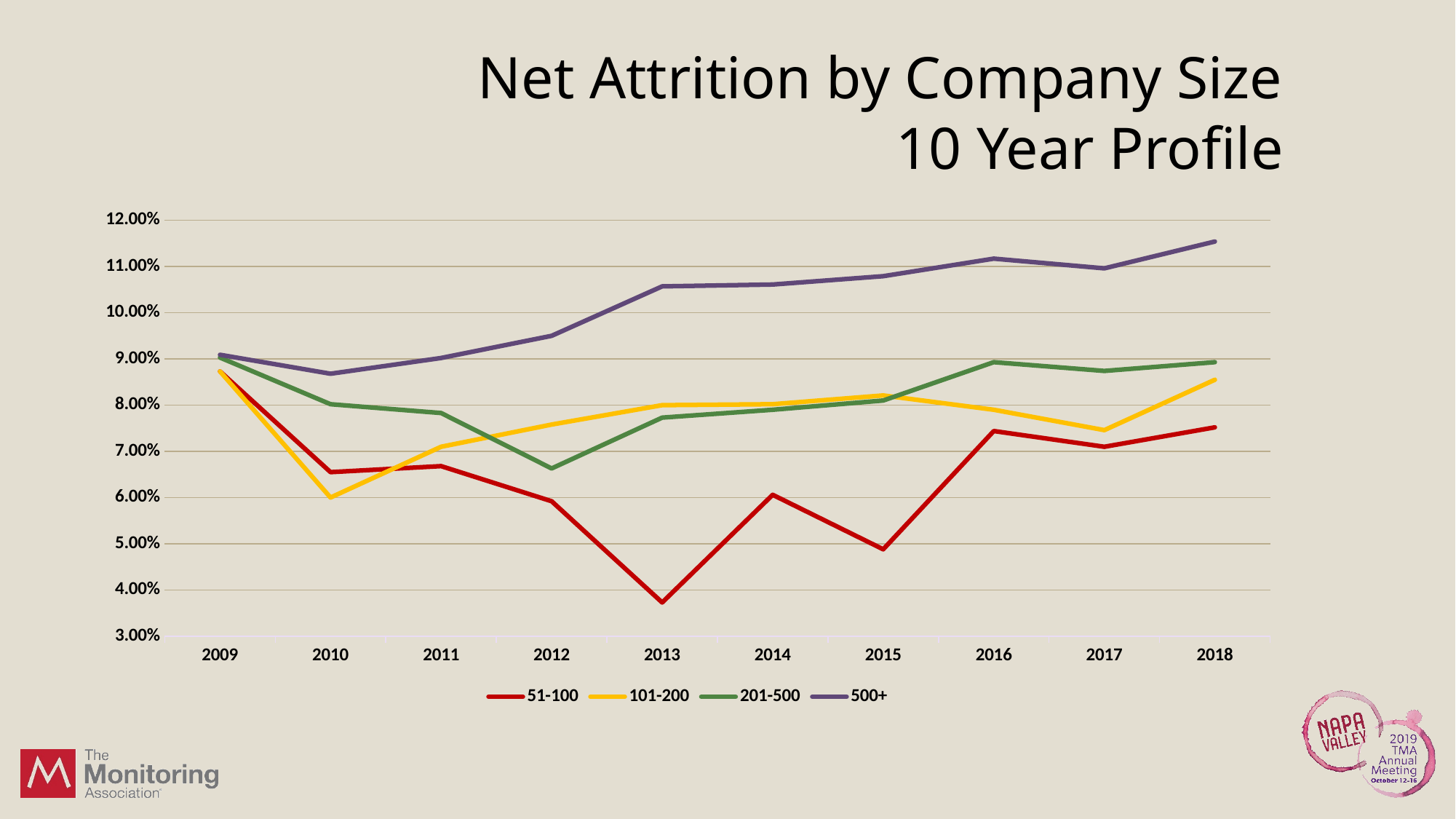
What colour is the line for the 51-100 series? Red What kind of chart is shown on the slide? Line chart Is the value for the 500+ series in 2018 greater or less than 11.00%? greater In 2012, which series has the larger value: 201-500 or 101-200? 101-200 Which company size series has the lowest net attrition in 2013? 51-100 Is the value for the 51-100 series in 2013 greater or less than 4.00%? less Which company size series has the highest net attrition in 2018? 500+ In which year does the 51-100 series reach its lowest value? 2013 Does the 500+ series rise or fall from 2012 to 2016? rise How many series does the legend list? 4 How many years are plotted along the x axis? 10 Is the value for the 101-200 series in 2010 greater or less than 7.00%? less